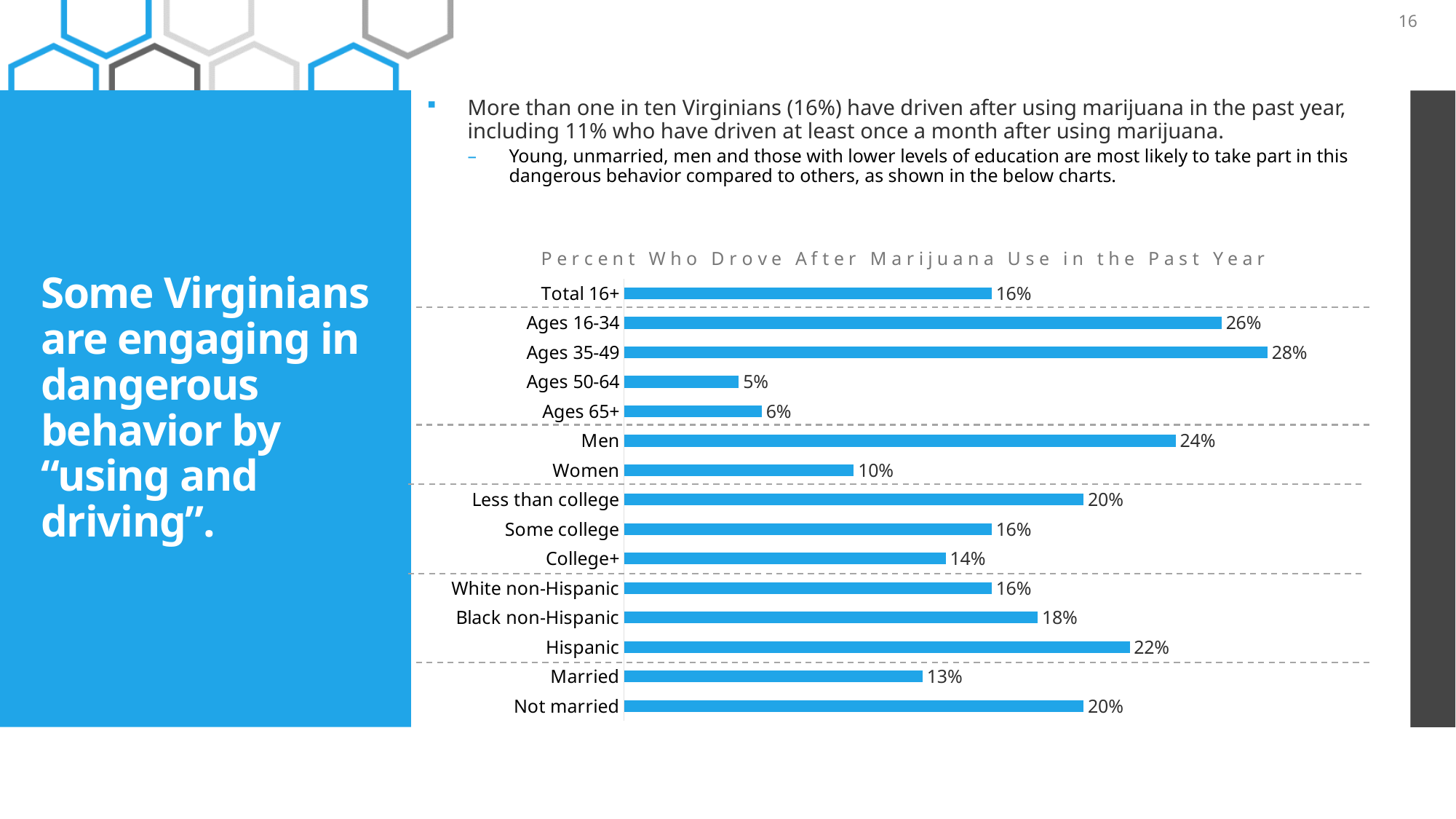
Which is larger, the value for Less than college or the value for College+? Less than college How many categories are shown in the chart? 15 Which category has the lowest value? Ages 50-64 What kind of chart is shown on the slide? Bar chart What is the title of the chart? Percent Who Drove After Marijuana Use in the Past Year What is the value for Ages 35-49? 28% What is the value for Hispanic? 22% What is the difference between the values for Not married and Married? 7% What is the value for Women? 10% What is the value for Total 16+? 16% What is the difference between the values for Men and Women? 14% Which category has the highest value? Ages 35-49